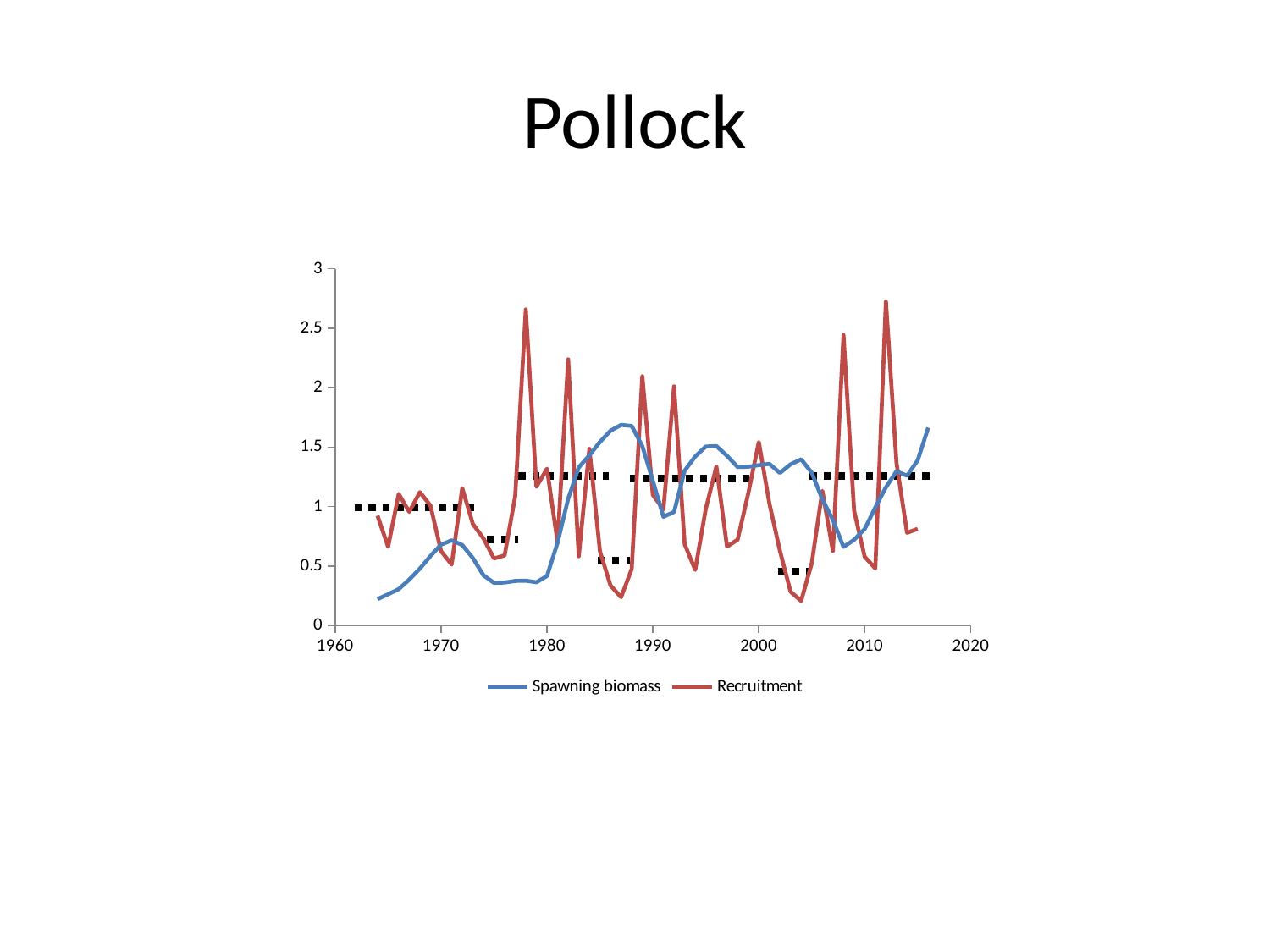
What kind of chart is shown on the slide? line chart Is the Recruitment value at its peak around 2012 greater or less than 2.5? greater What colour is the Recruitment line? red Is the Spawning biomass value in 1964 greater or less than 0.5? less Is the Recruitment value at its peak around 1978 greater or less than 2? greater Does the Spawning biomass line rise or fall between 1964 and 1970? rise How many series does the legend list? 2 What is the title of the chart? Pollock Which series has the larger value in 2012, Spawning biomass or Recruitment? Recruitment Does the Spawning biomass line rise or fall between 1988 and 1991? fall